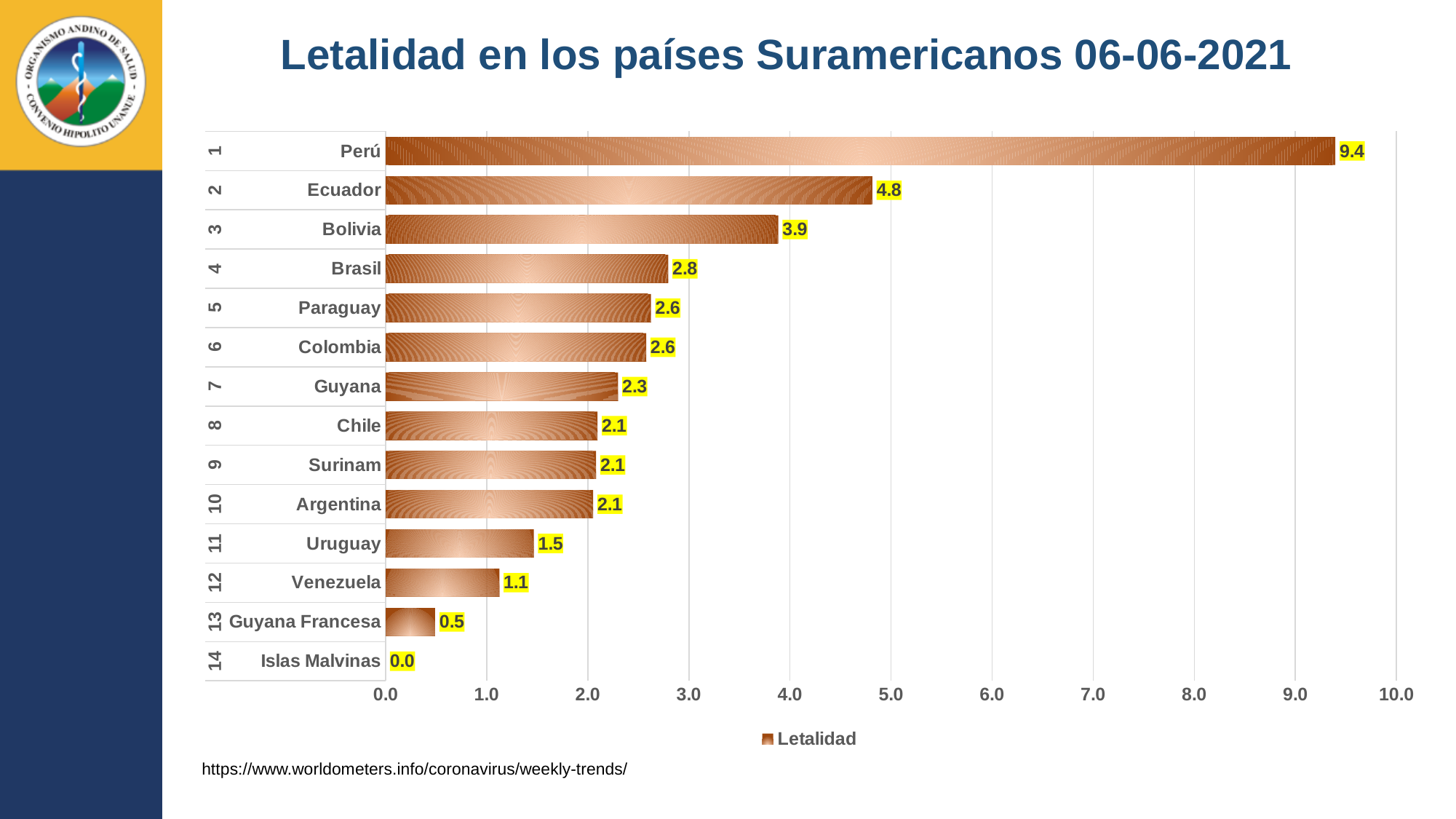
What is the Letalidad value for Uruguay? 1.5 How many series does the legend list? 1 What is the Letalidad value for Bolivia? 3.9 What is the difference between the Letalidad values of Perú and Ecuador? 4.6 What is the Letalidad value for Perú? 9.4 Which has a larger Letalidad value, Brasil or Venezuela? Brasil What is the title of the chart? Letalidad en los países Suramericanos 06-06-2021 Which country has the lowest Letalidad value? Islas Malvinas How many countries are shown in the chart? 14 What kind of chart is shown on the slide? Bar chart Which country has the highest Letalidad value? Perú Is the value for Ecuador greater or less than 4.0? greater